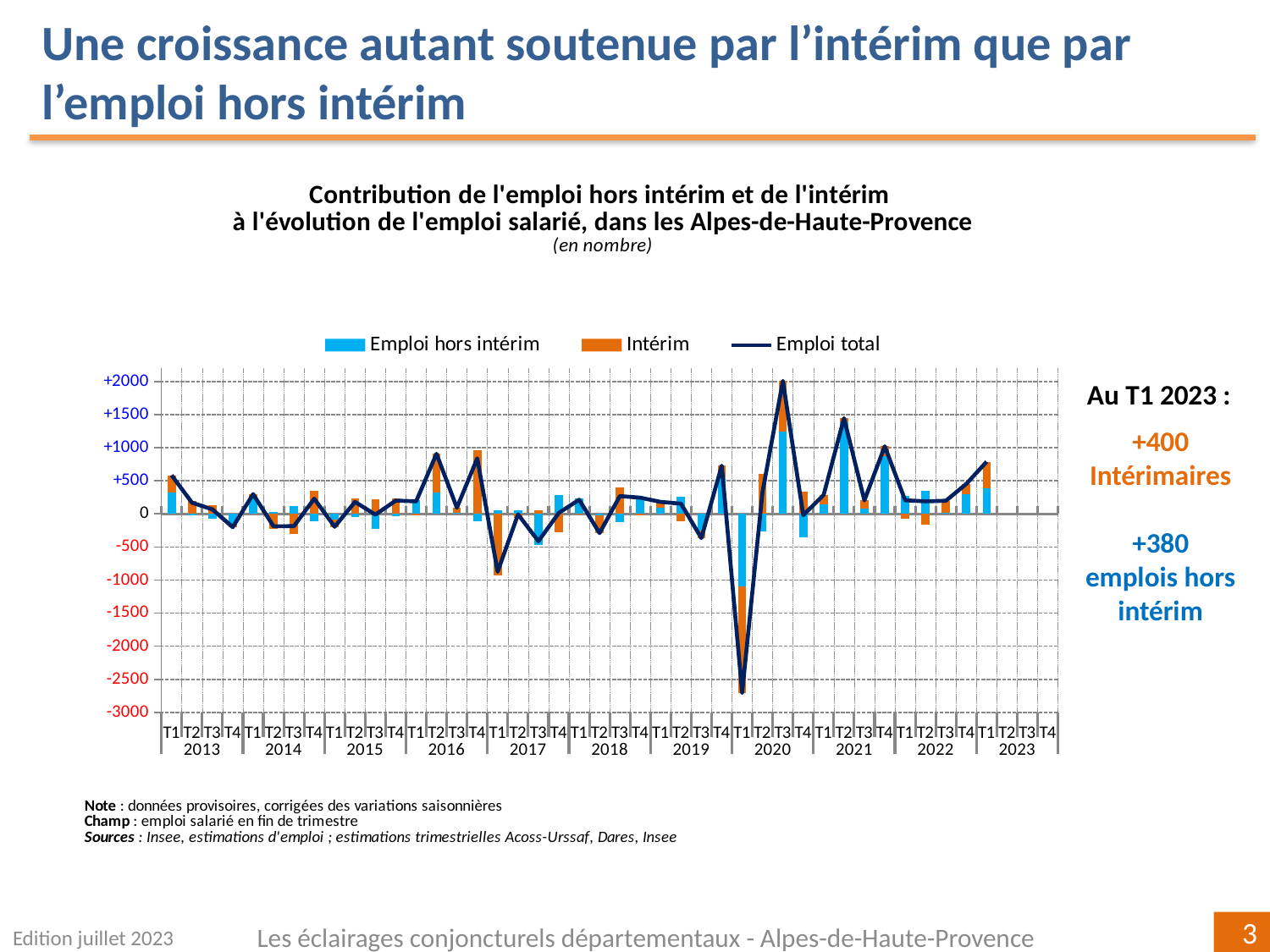
What are the three series named in the chart legend? Emploi hors intérim, Intérim, Emploi total In which quarter does the Emploi total line reach its highest value? T3 2020 How many series does the chart legend list? 3 According to the slide, what is the contribution of emploi hors intérim at T1 2023? +380 What kind of chart is shown on the slide? A bar chart combined with a line chart Is the Emploi total value at T1 2020 greater or less than -2500? less How many years are labelled along the x axis of the chart? 11 In which quarter does the Emploi total line reach its lowest value? T1 2020 At T1 2023, what is the total of the Intérim and emploi hors intérim contributions? +780 According to the slide, what is the contribution of Intérim at T1 2023? +400 At T1 2023, what is the difference between the Intérim contribution and the emploi hors intérim contribution? 20 At T1 2023, which contribution is larger: Intérim or emploi hors intérim? Intérim